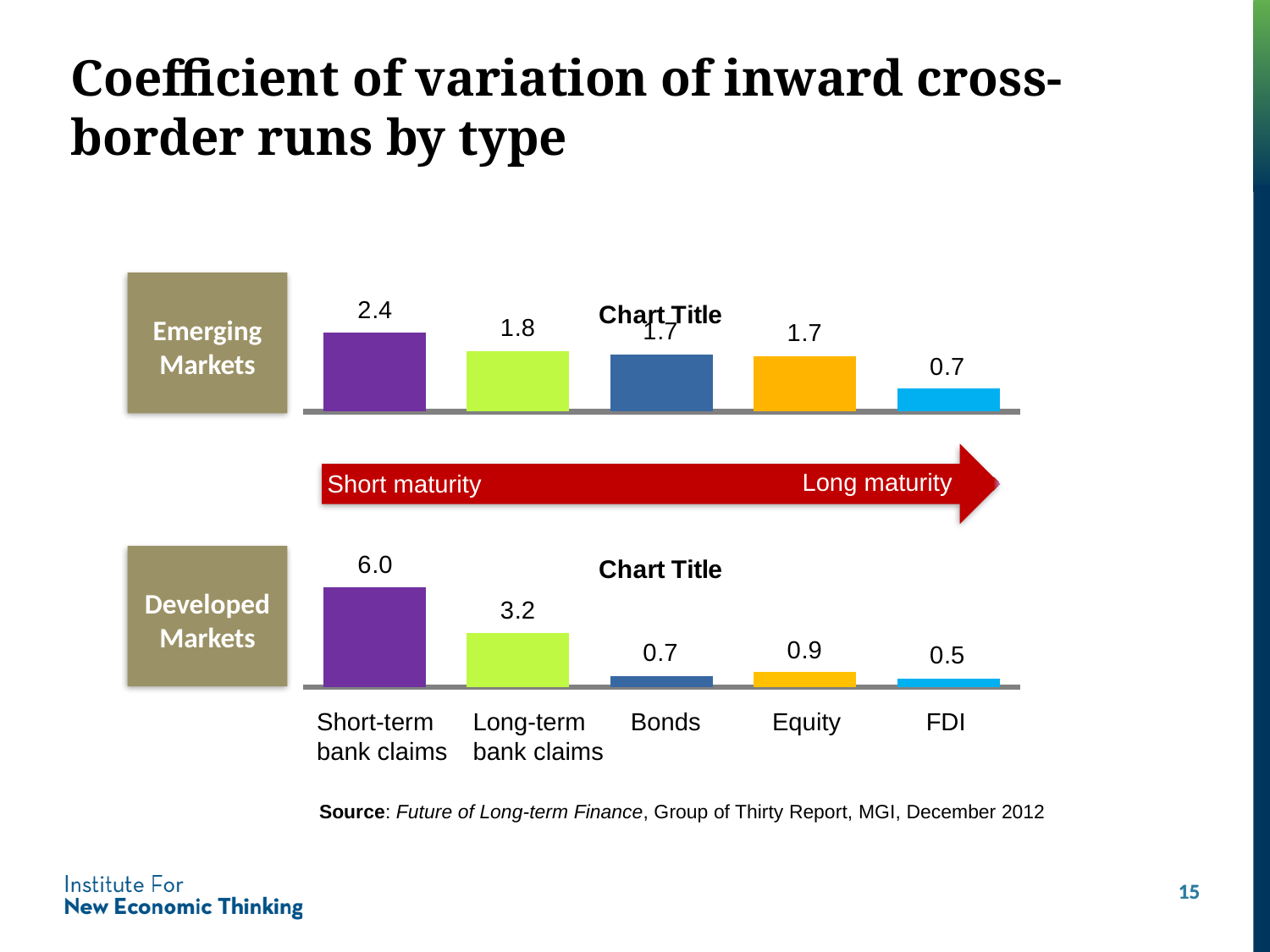
In the bottom (Developed Markets) chart, which category has the highest value? Short-term bank claims What kind of chart is the top (Emerging Markets) chart? Bar chart In the bottom (Developed Markets) chart, do the values generally rise or fall from Short-term bank claims to FDI? Fall In the top (Emerging Markets) chart, what is the difference between Short-term bank claims and FDI? 1.7 Which chart has the larger value for Short-term bank claims, the top (Emerging Markets) chart or the bottom (Developed Markets) chart? Developed Markets In the bottom (Developed Markets) chart, what is the value for Equity? 0.9 How many categories are shown in the bottom (Developed Markets) chart? 5 In the top (Emerging Markets) chart, what is the value for Short-term bank claims? 2.4 In the top (Emerging Markets) chart, which category has the lowest value? FDI In the bottom (Developed Markets) chart, what is the difference between Short-term bank claims and Long-term bank claims? 2.8 In the bottom (Developed Markets) chart, which is larger, Bonds or Equity? Equity In the bottom (Developed Markets) chart, what is the value for Long-term bank claims? 3.2